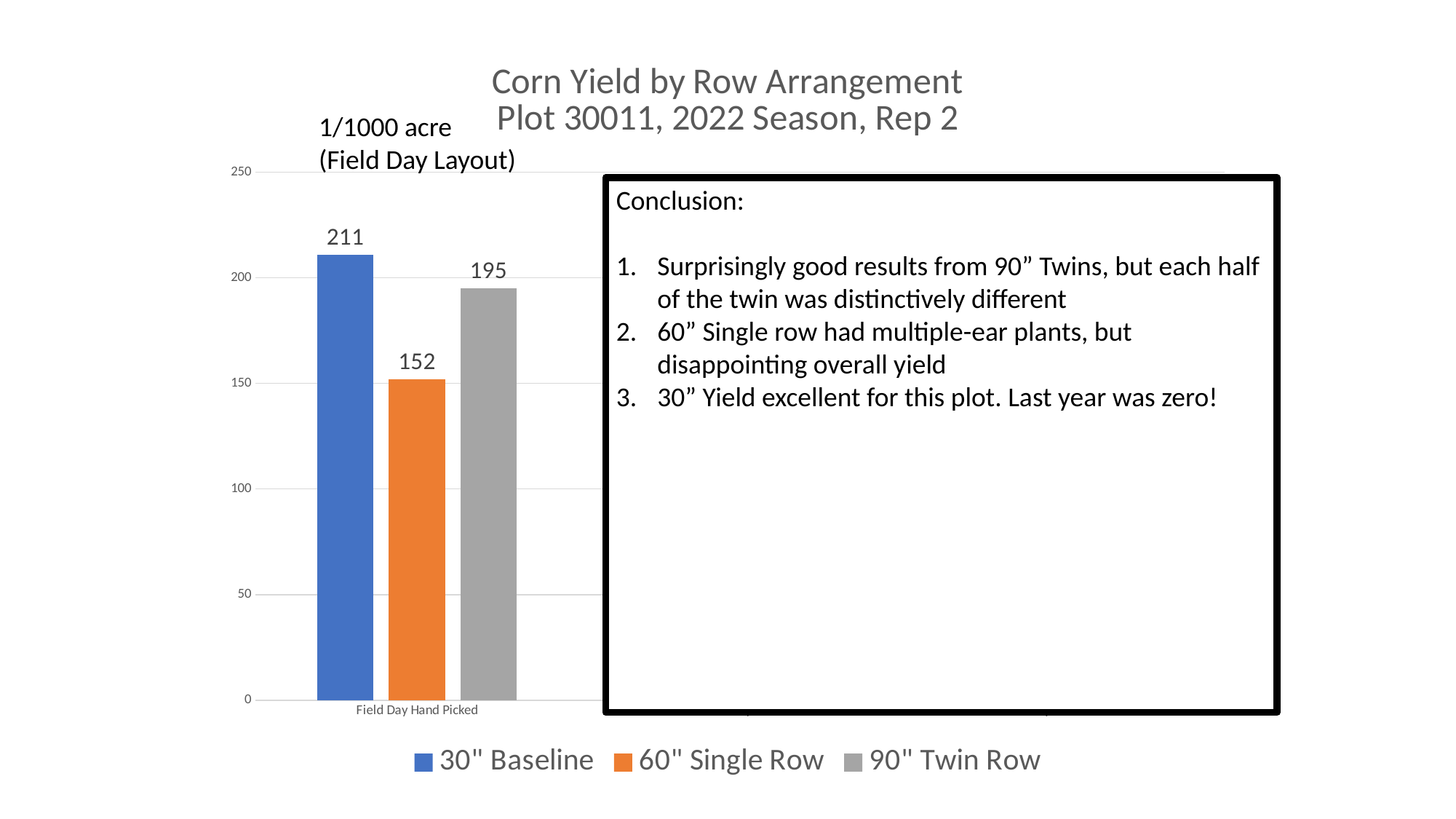
Is the value for 60" Single Row greater or less than 200? less What is the value for 90" Twin Row in the Field Day Hand Picked category? 195 What colour is the bar for 60" Single Row? orange What is the value for 60" Single Row in the Field Day Hand Picked category? 152 What is the difference between the 30" Baseline and 60" Single Row values? 59 Which series has the highest value in the Field Day Hand Picked category? 30" Baseline Which is larger, the value for 90" Twin Row or the value for 60" Single Row? 90" Twin Row Which series has the lowest value in the Field Day Hand Picked category? 60" Single Row What is the difference between the 30" Baseline and 90" Twin Row values? 16 How many series does the legend list? 3 What kind of chart is shown on the slide? bar chart What is the value for 30" Baseline in the Field Day Hand Picked category? 211